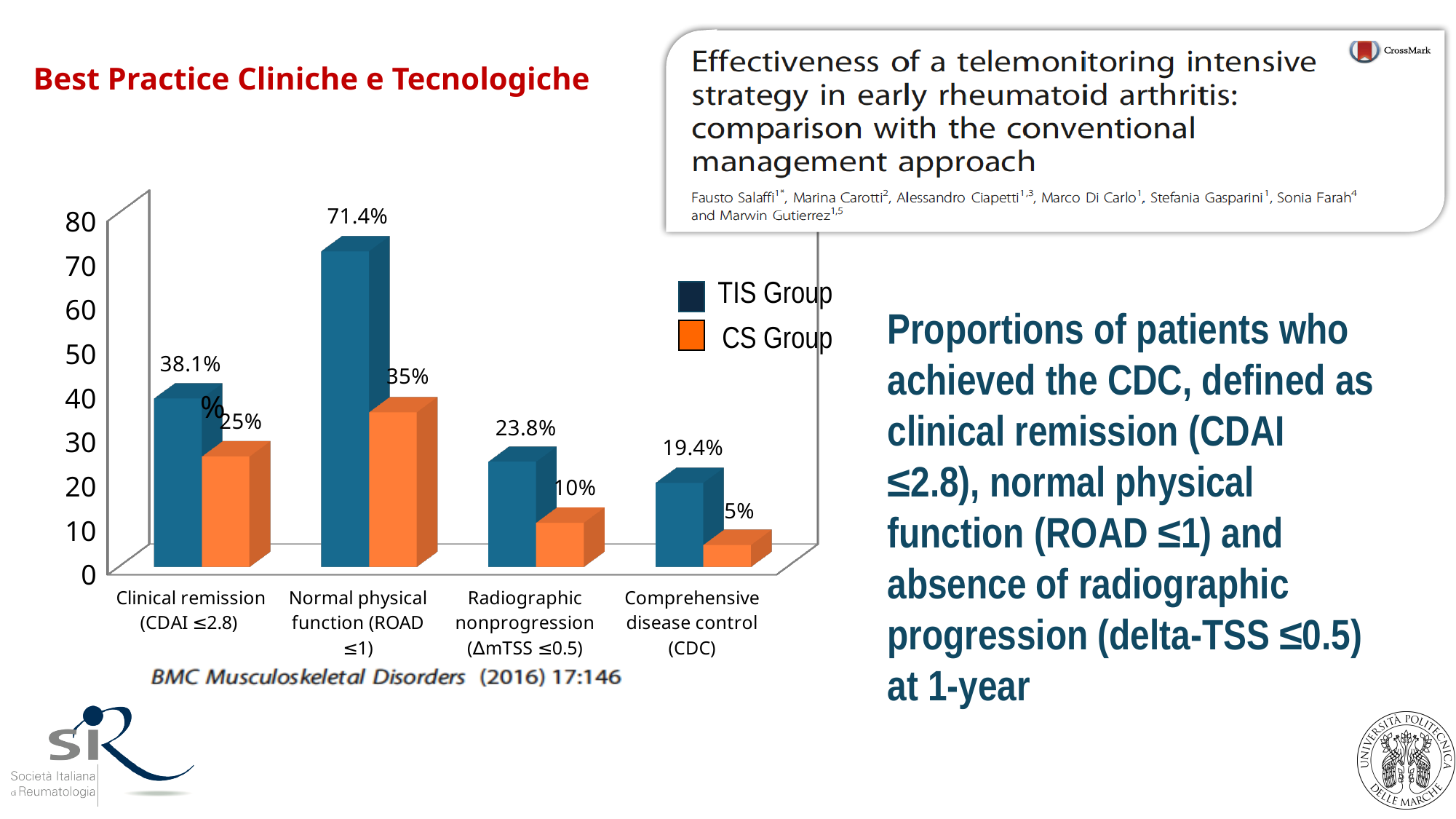
What is the value for the TIS Group in the Clinical remission (CDAI ≤2.8) category? 38.1% What kind of chart is shown on the slide? Bar chart Is the TIS Group value for Normal physical function (ROAD ≤1) greater or less than 60? greater In which category does the CS Group have its lowest value? Comprehensive disease control (CDC) How many categories are shown on the x axis of the chart? 4 What is the value for the CS Group in the Comprehensive disease control (CDC) category? 5% In which category does the TIS Group have its highest value? Normal physical function (ROAD ≤1) What is the value for the TIS Group in the Radiographic nonprogression (ΔmTSS ≤0.5) category? 23.8% What is the value for the CS Group in the Normal physical function (ROAD ≤1) category? 35% Which group has the larger value for Radiographic nonprogression (ΔmTSS ≤0.5), TIS Group or CS Group? TIS Group What is the difference between the TIS Group and CS Group values for Comprehensive disease control (CDC)? 14.4% How many series does the legend list? 2